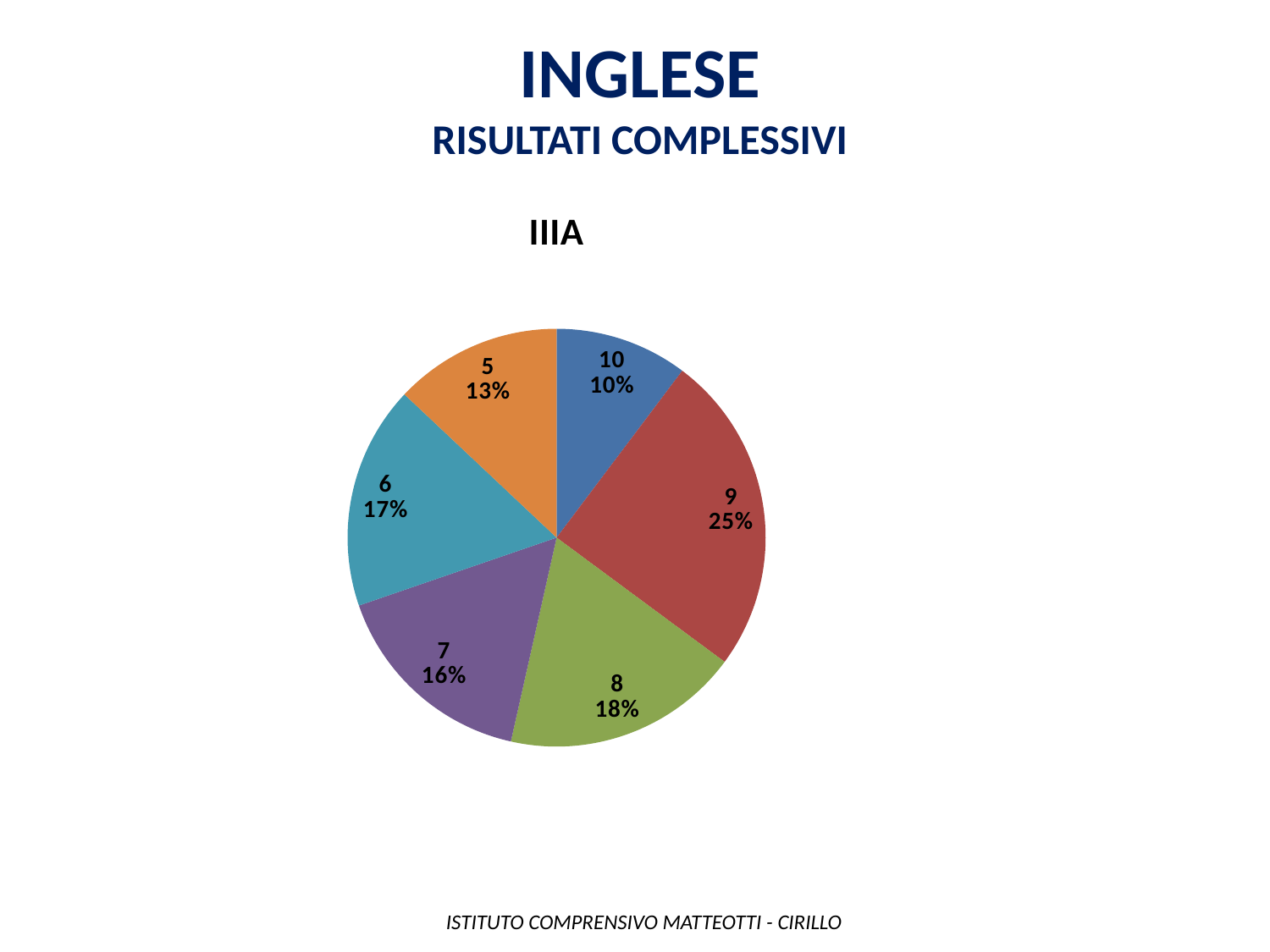
Which grade has the smallest slice of the pie? 10 Which grade has the largest slice of the pie? 9 How many slices does the pie chart have? 6 What share of the pie does the slice for grade 6 represent? 17% What share of the pie does the slice for grade 5 represent? 13% What colour is the slice for grade 8? green Which slice is larger, the one for grade 7 or the one for grade 5? 7 What share of the pie does the slice for grade 9 represent? 25% What kind of chart is shown on the slide? pie chart What is the title of the chart? IIIA What is the difference in percentage points between the slice for grade 9 and the slice for grade 8? 7%